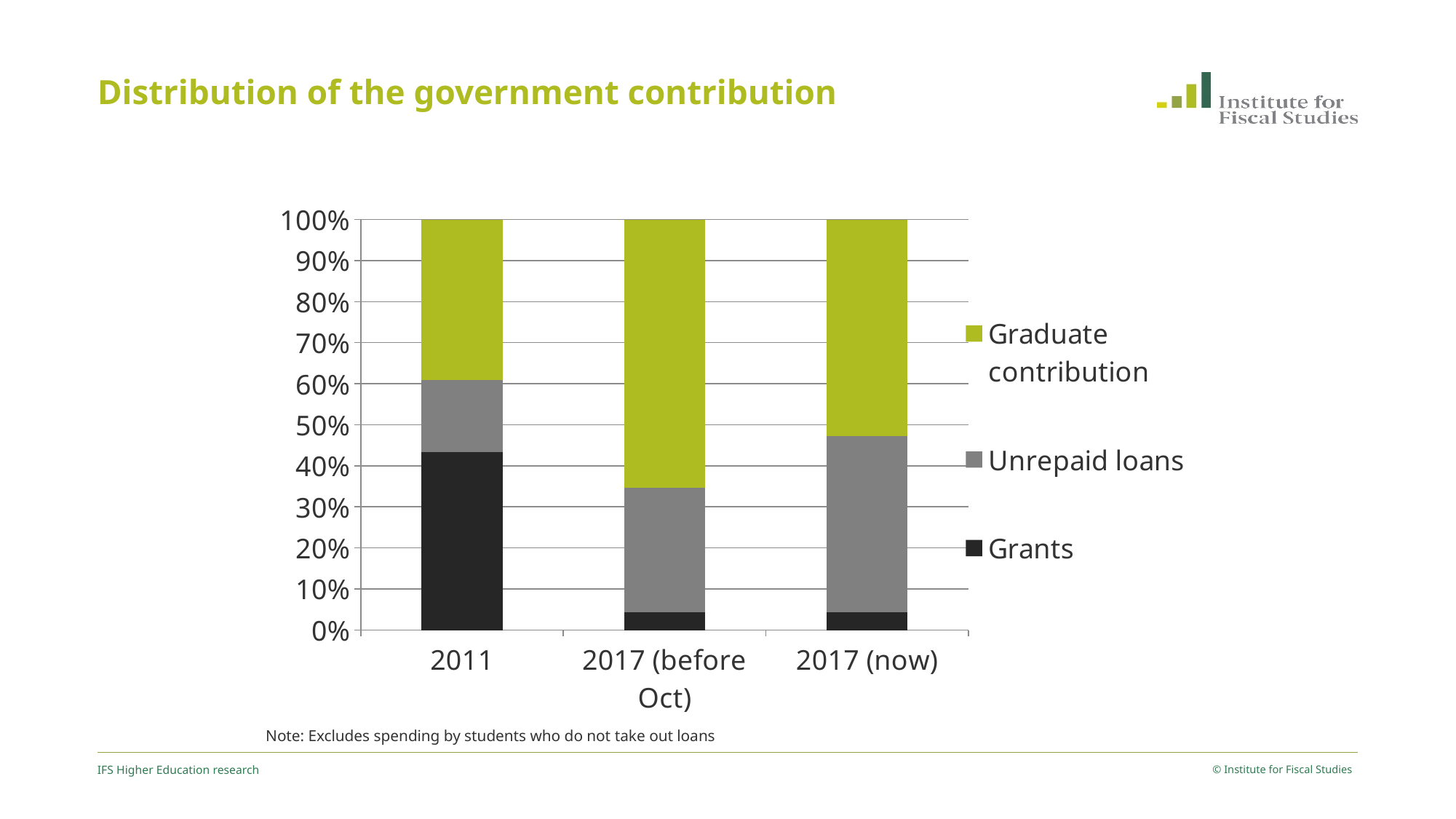
Is the Grants share for 2011 greater or less than 40%? greater Which is larger, the Unrepaid loans share for 2011 or for 2017 (now)? 2017 (now) Is the Graduate contribution share for 2017 (before Oct) greater or less than 60%? greater What kind of chart is shown on the slide? Stacked bar chart Is the Grants share for 2017 (now) greater or less than 10%? less Which series is shown in dark grey/black at the bottom of each bar? Grants Which category has the largest Grants share? 2011 How many series does the legend list? 3 What is the title of the chart? Distribution of the government contribution Which category has the largest Graduate contribution share? 2017 (before Oct) How many categories are shown on the x axis? 3